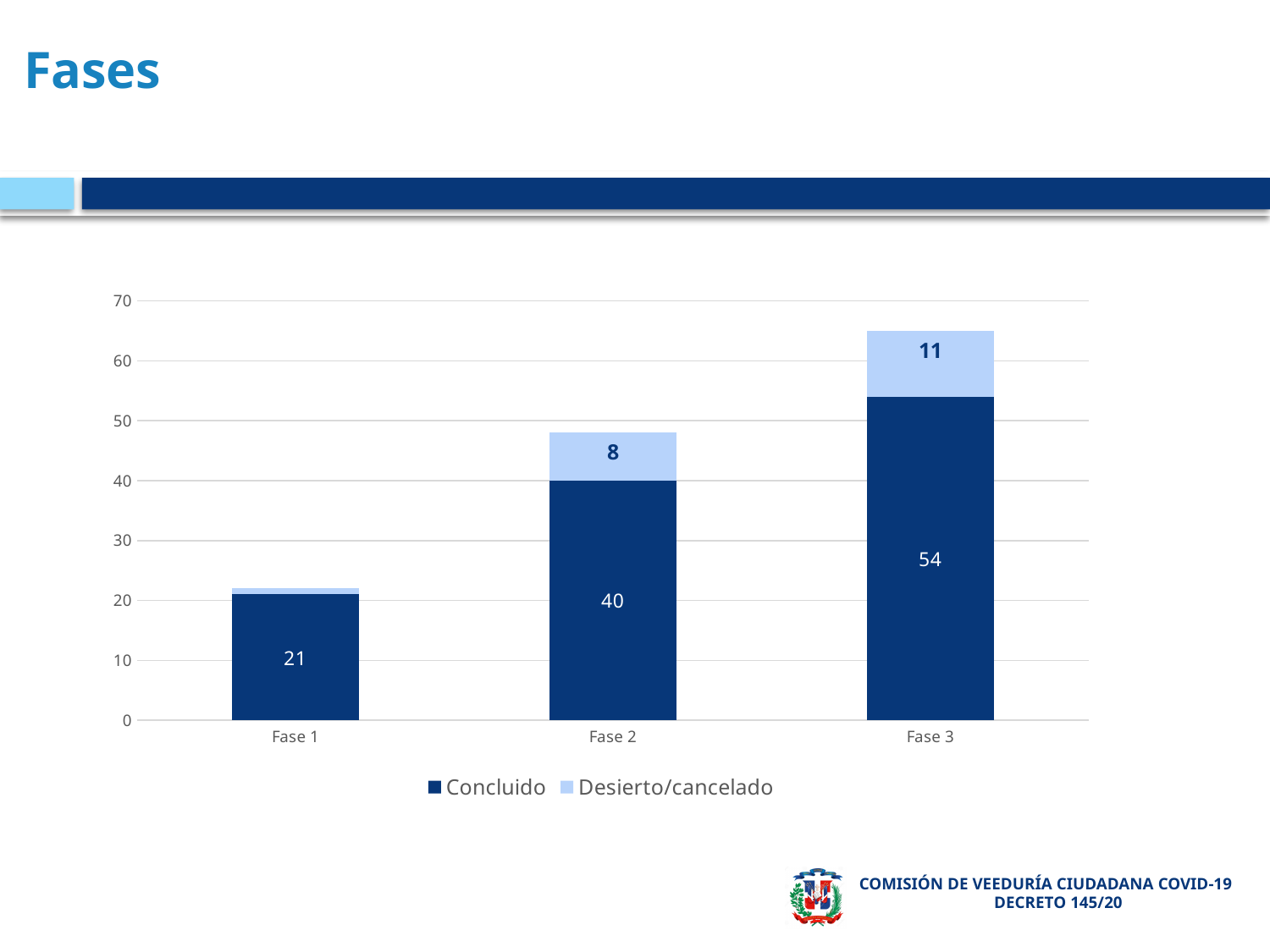
Which phase has the lowest Concluido value? Fase 1 How many series does the legend list? 2 Is the total height of the Fase 3 bar greater or less than 60? greater Which phase has the highest Concluido value? Fase 3 How many phases are shown on the x axis? 3 What is the Concluido value for Fase 2? 40 Which is larger, the Desierto/cancelado value for Fase 2 or for Fase 3? Fase 3 What is the total of the stacked bar for Fase 2? 48 What is the Desierto/cancelado value for Fase 3? 11 What kind of chart is shown on the slide? Stacked bar chart What is the difference between the Concluido values for Fase 3 and Fase 2? 14 What is the Concluido value for Fase 1? 21